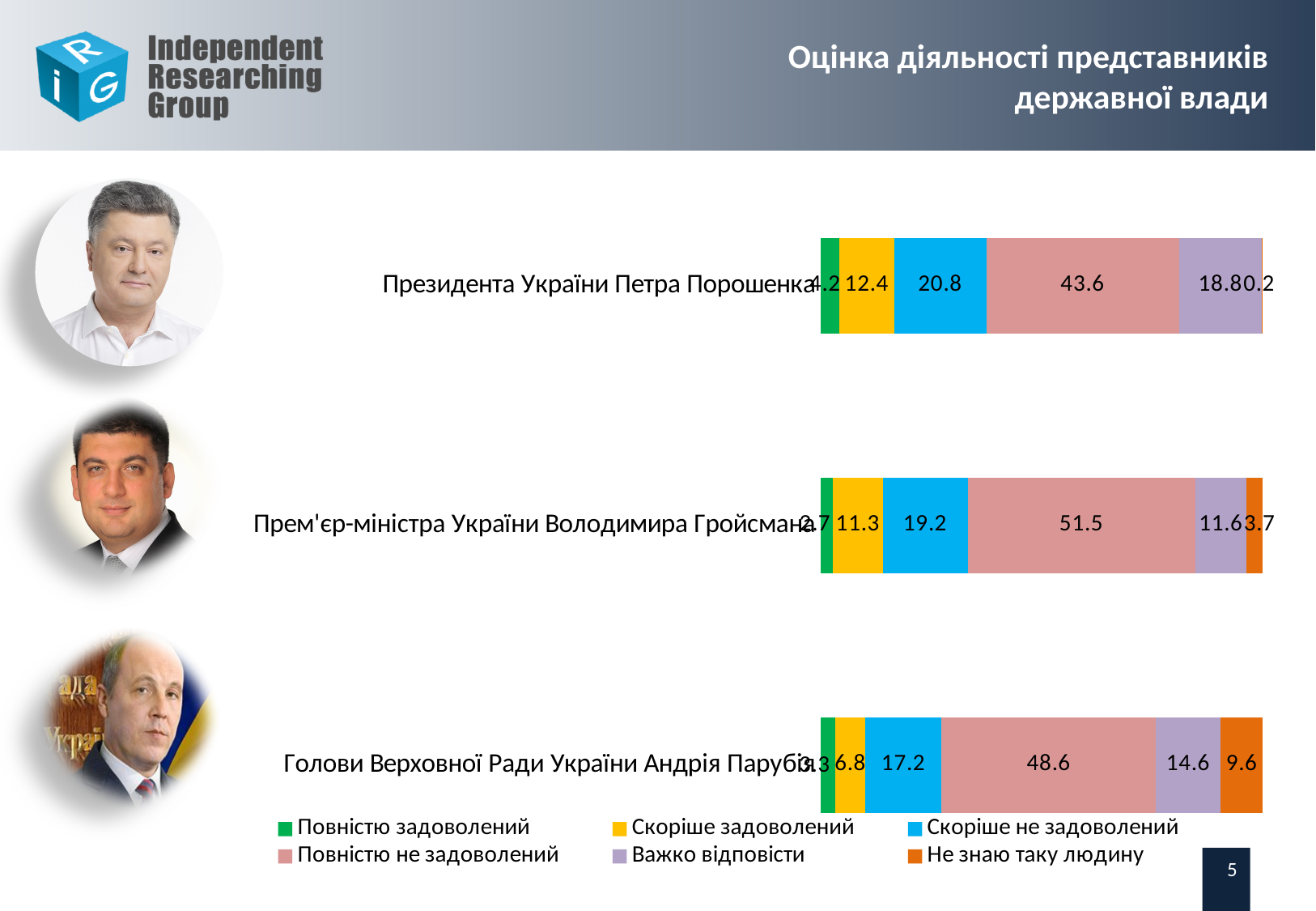
Which is larger: the «Скоріше не задоволений» value for Петра Порошенка or for Андрія Парубія? Петра Порошенка What is the value of «Повністю не задоволений» for Президента України Петра Порошенка? 43.6 What is the value of «Важко відповісти» for Голови Верховної Ради України Андрія Парубія? 14.6 Which official has the lowest value for «Скоріше задоволений»? Голови Верховної Ради України Андрія Парубія What is the difference between the «Повністю не задоволений» values for Володимира Гройсмана and Петра Порошенка? 7.9 How many officials (categories) are shown in the chart? 3 Which official has the highest value for «Повністю не задоволений»? Прем'єр-міністра України Володимира Гройсмана What is the value of «Не знаю таку людину» for Голови Верховної Ради України Андрія Парубія? 9.6 What is the value of «Скоріше не задоволений» for Прем'єр-міністра України Володимира Гройсмана? 19.2 How many series does the legend list? 6 What kind of chart is shown on the slide? Stacked bar chart What is the difference between the «Скоріше задоволений» values for Петра Порошенка and Володимира Гройсмана? 1.1